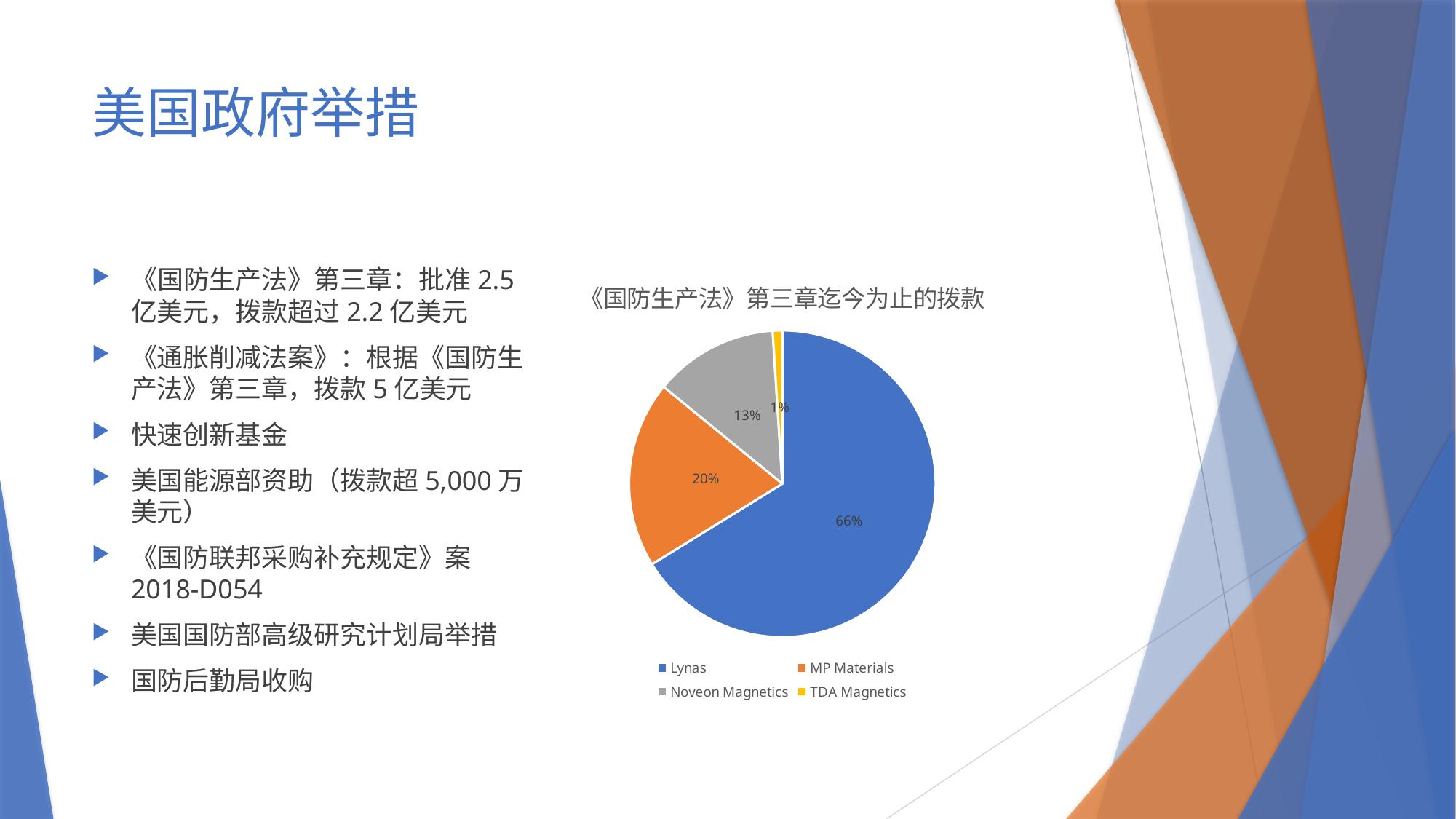
Which company has the largest slice of the pie? Lynas Which company has the smallest slice of the pie? TDA Magnetics What share of the pie does TDA Magnetics hold? 1% What share of the pie does Noveon Magnetics hold? 13% What is the difference in percentage points between the Lynas and MP Materials slices? 46 How many companies are shown in the pie chart? 4 Which slice is larger, MP Materials or Noveon Magnetics? MP Materials What share of the pie does MP Materials hold? 20% What is the title of the chart? 《国防生产法》第三章迄今为止的拨款 What kind of chart is shown on the slide? pie chart What colour is the Noveon Magnetics slice? grey